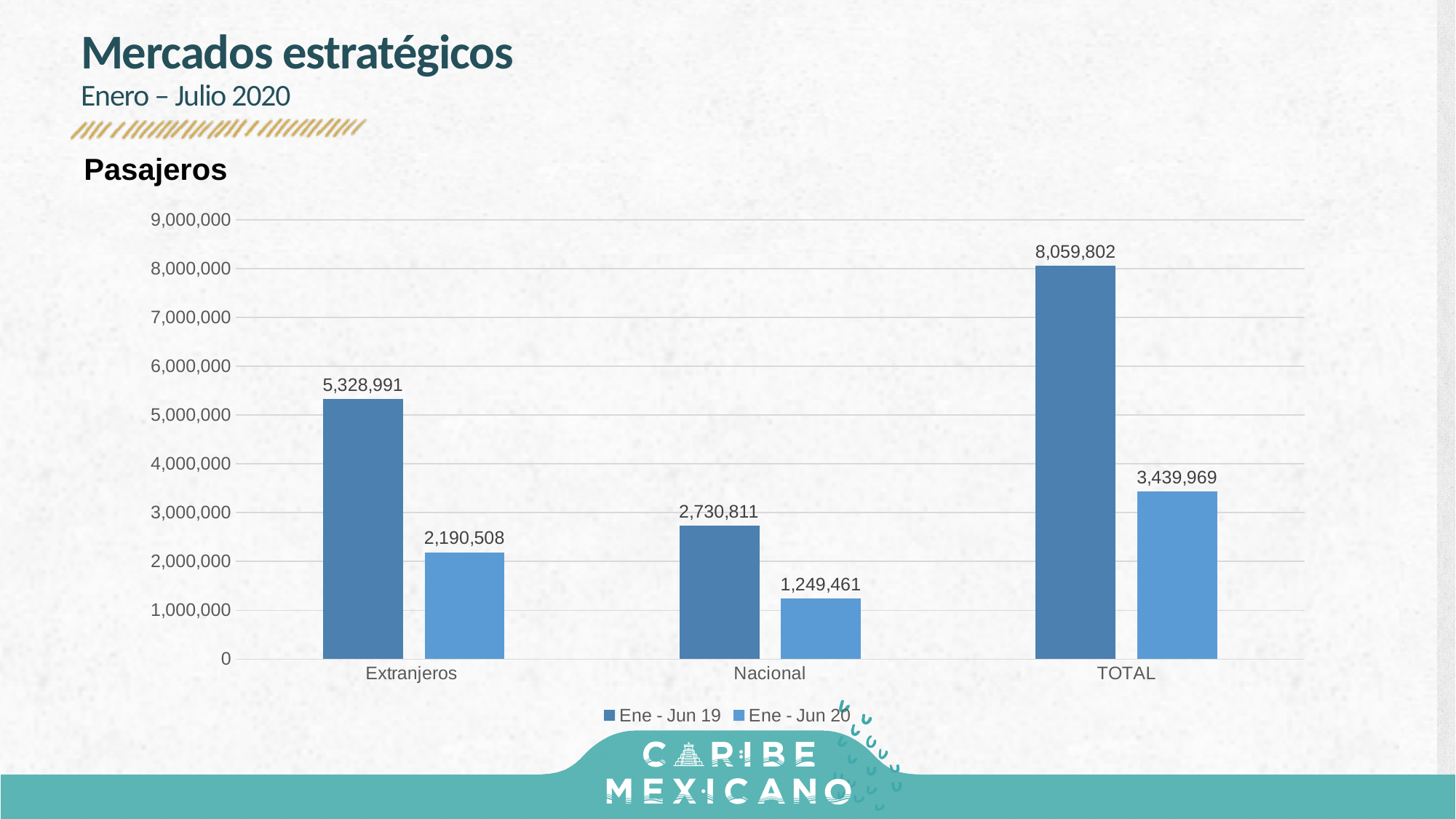
What is the value for Nacional in the Ene - Jun 19 series? 2,730,811 Which category has the lowest value in the Ene - Jun 20 series? Nacional Which is larger: the Ene - Jun 20 value for Extranjeros or the Ene - Jun 19 value for Nacional? Ene - Jun 19 value for Nacional What kind of chart is shown on the slide? Bar chart What is the value for Nacional in the Ene - Jun 20 series? 1,249,461 What is the difference between the Ene - Jun 19 and Ene - Jun 20 values for TOTAL? 4,619,833 What is the difference between the Ene - Jun 19 and Ene - Jun 20 values for Extranjeros? 3,138,483 How many categories are shown on the x axis? 3 What is the TOTAL value for Ene - Jun 20? 3,439,969 How many series does the legend list? 2 Which category has the highest value in the Ene - Jun 19 series? TOTAL What is the value for Extranjeros in the Ene - Jun 19 series? 5,328,991